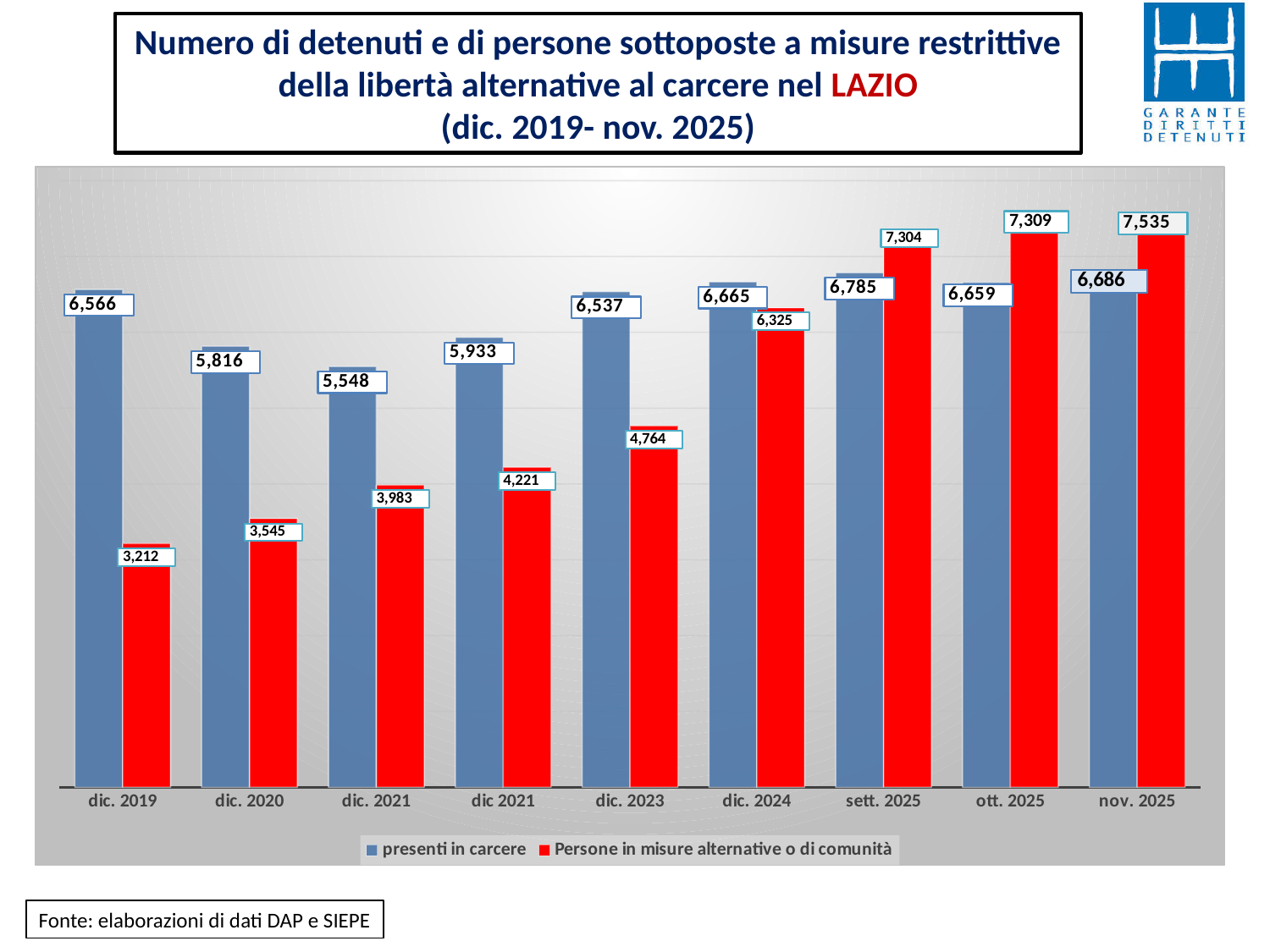
What is the value for 'presenti in carcere' in dic. 2019? 6,566 In which period is the value for 'Persone in misure alternative o di comunità' highest? nov. 2025 How many periods are shown on the x axis? 9 How many series does the legend list? 2 What kind of chart is shown on the slide? bar chart What is the difference between 'presenti in carcere' and 'Persone in misure alternative o di comunità' in dic. 2019? 3,354 What is the value for 'presenti in carcere' in ott. 2025? 6,659 In which period is the value for 'Persone in misure alternative o di comunità' lowest? dic. 2019 What is the value for 'Persone in misure alternative o di comunità' in nov. 2025? 7,535 In which period is the value for 'presenti in carcere' highest? sett. 2025 What is the difference between 'Persone in misure alternative o di comunità' and 'presenti in carcere' in nov. 2025? 849 In dic. 2024, which series has the larger value: 'presenti in carcere' or 'Persone in misure alternative o di comunità'? presenti in carcere